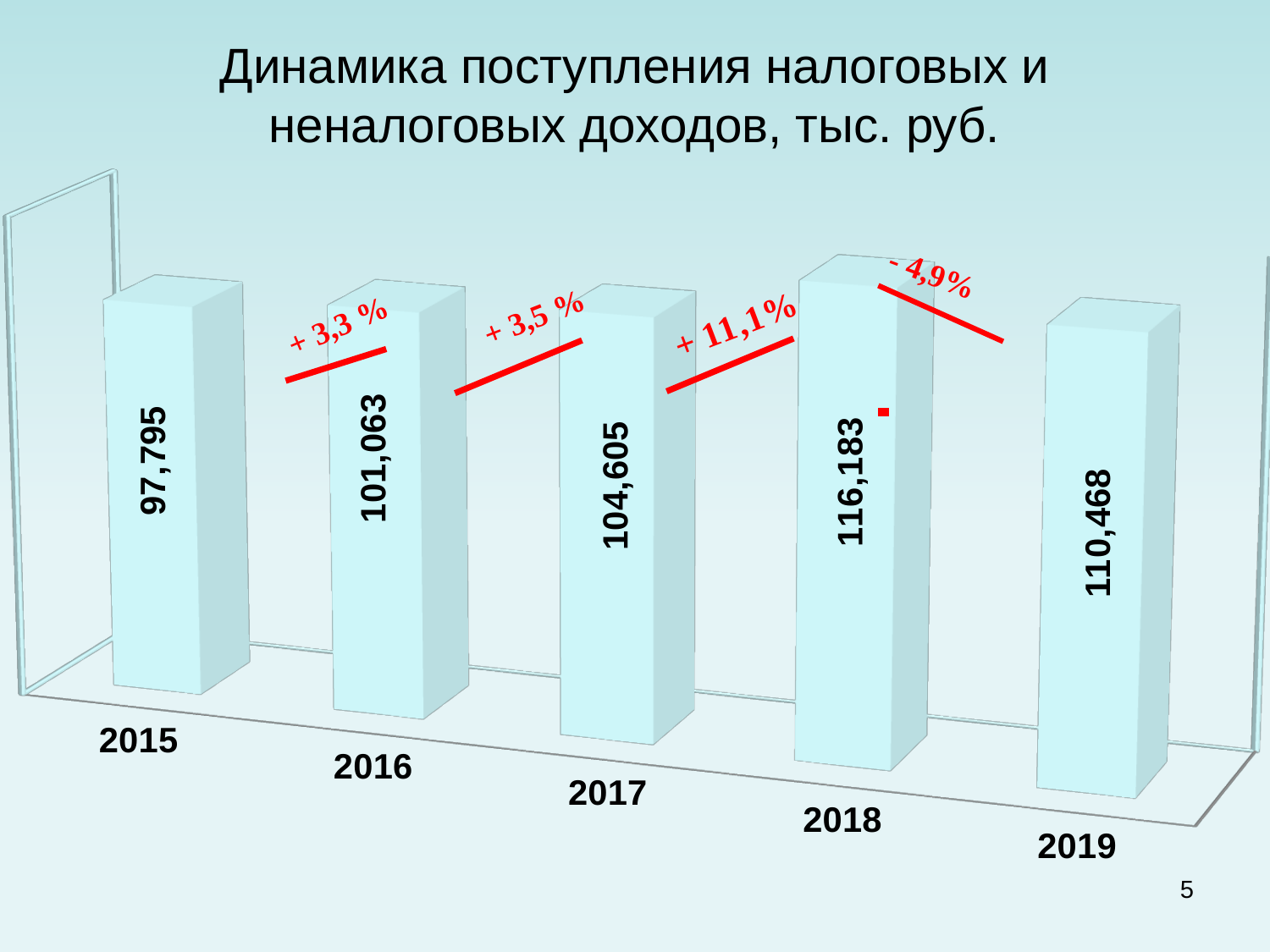
How many years are shown on the chart? 5 Which is larger, the value for 2017 or the value for 2019? 2019 What is the difference between the values for 2018 and 2019? 5,715 Which year has the lowest value? 2015 Which year has the highest value? 2018 What percentage change is annotated between 2017 and 2018? + 11,1% What is the difference between the values for 2016 and 2015? 3,268 What kind of chart is shown on the slide? bar chart What is the title of the chart? Динамика поступления налоговых и неналоговых доходов, тыс. руб. What is the value for 2018? 116,183 What is the value for 2019? 110,468 What is the value for 2015? 97,795